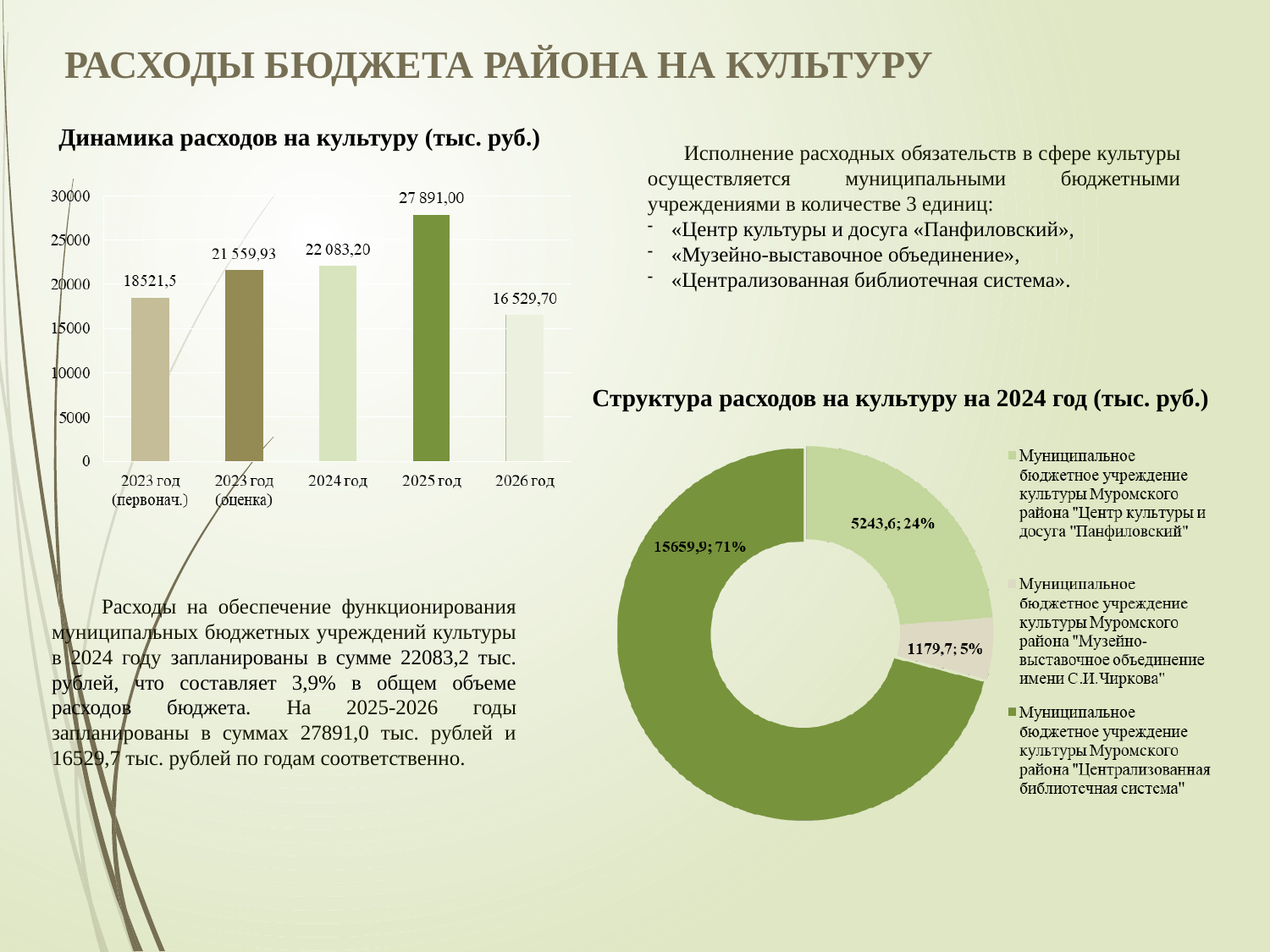
In the bar chart 'Динамика расходов на культуру (тыс. руб.)', which is larger: the value for 2023 год (оценка) or the value for 2026 год? 2023 год (оценка) In the doughnut chart 'Структура расходов на культуру на 2024 год (тыс. руб.)', what is the value for 'Музейно-выставочное объединение имени С.И.Чиркова'? 1179,7 In the bar chart 'Динамика расходов на культуру (тыс. руб.)', which year has the highest value? 2025 год In the bar chart 'Динамика расходов на культуру (тыс. руб.)', what is the value for 2023 год (первонач.)? 18521,5 In the bar chart 'Динамика расходов на культуру (тыс. руб.)', which category has the lowest value? 2026 год In the bar chart 'Динамика расходов на культуру (тыс. руб.)', what is the value for 2025 год? 27 891,00 In the doughnut chart 'Структура расходов на культуру на 2024 год (тыс. руб.)', what share does the 'Централизованная библиотечная система' slice have? 71% In the bar chart 'Динамика расходов на культуру (тыс. руб.)', is the value for 2024 год greater or less than 20000? greater What type of chart is 'Структура расходов на культуру на 2024 год (тыс. руб.)'? Doughnut chart How many entries does the legend of the doughnut chart 'Структура расходов на культуру на 2024 год (тыс. руб.)' list? 3 In the bar chart 'Динамика расходов на культуру (тыс. руб.)', what is the difference between the values for 2025 год and 2026 год? 11 361,30 In the bar chart 'Динамика расходов на культуру (тыс. руб.)', how many bars are plotted? 5